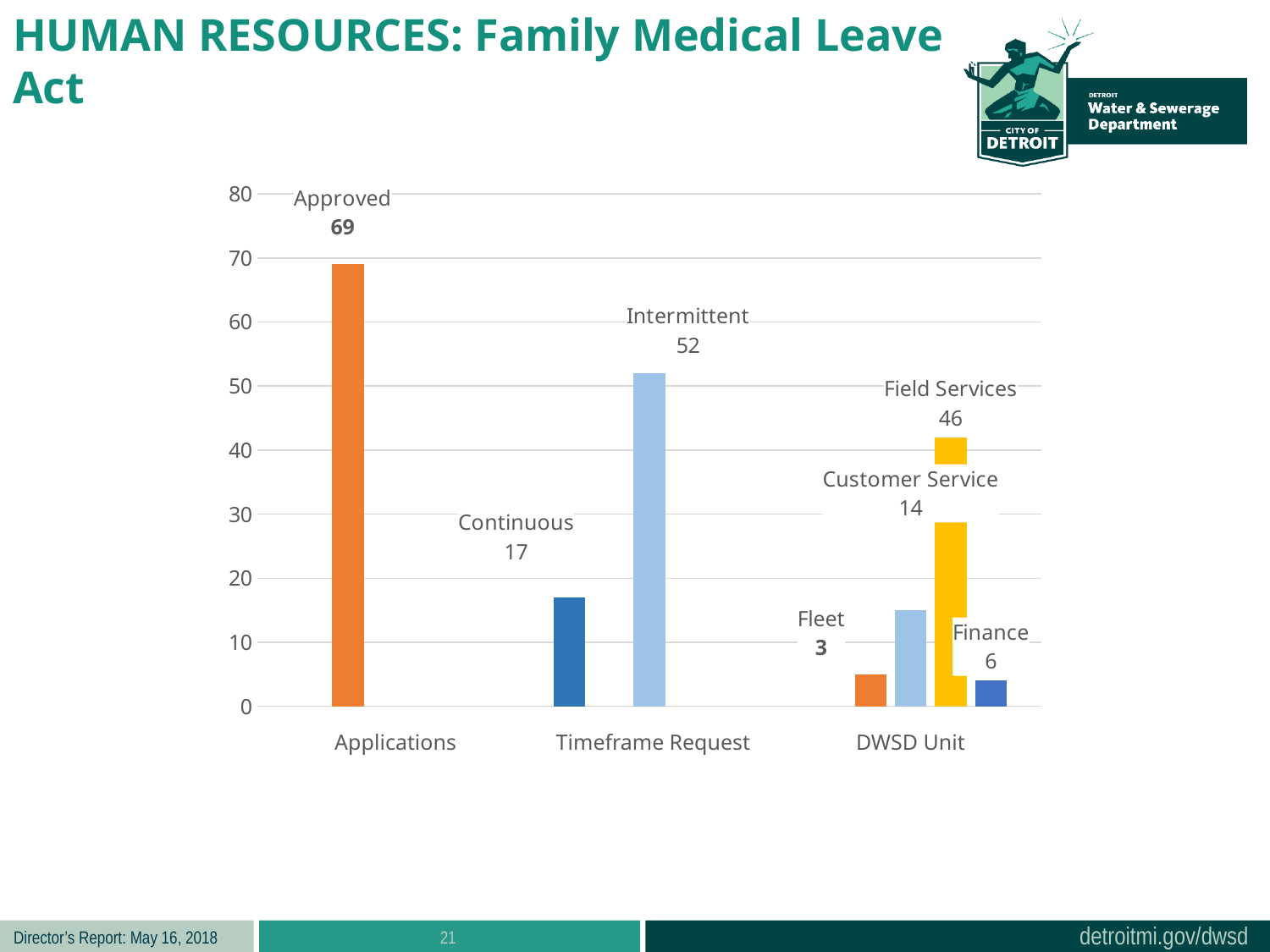
What is the value labelled for Intermittent under Timeframe Request? 52 What value is labelled for Fleet under DWSD Unit? 3 What value is labelled for Finance under DWSD Unit? 6 What value is labelled for Field Services under DWSD Unit? 46 What is the value labelled for Continuous under Timeframe Request? 17 What kind of chart is shown on the slide? Bar chart What is the difference between the Intermittent and Continuous values under Timeframe Request? 35 How many category groups are shown along the x axis? 3 What value is labelled for Customer Service under DWSD Unit? 14 Which is larger, the labelled value for Field Services or for Customer Service? Field Services What is the value of the Approved bar under Applications? 69 Which labelled bar has the highest value on the chart? Approved